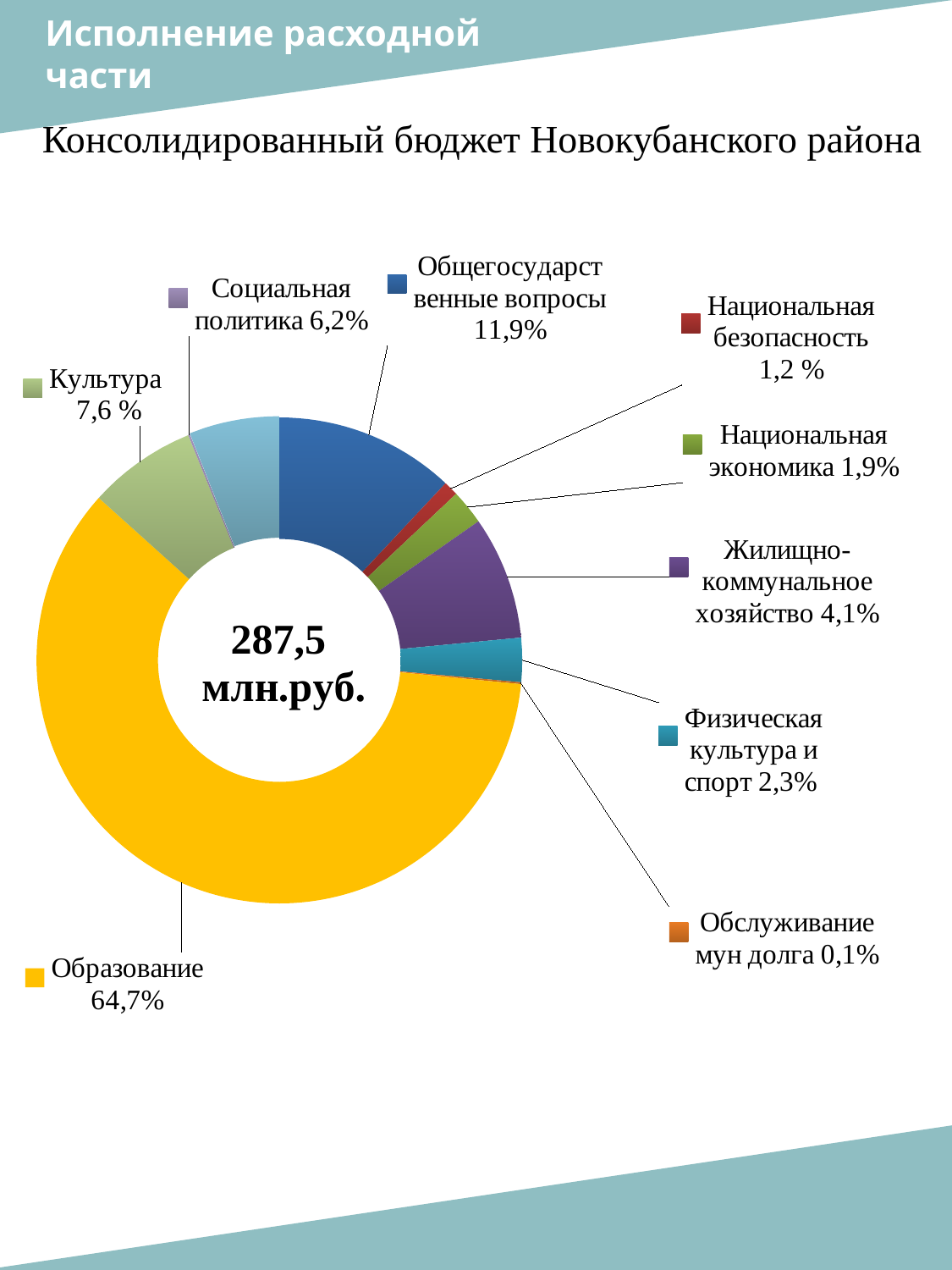
How many categories are shown in the chart? 9 What share of the budget goes to Жилищно-коммунальное хозяйство? 4,1% What share of the budget goes to Культура? 7,6 % Which category has the largest share of the budget? Образование What kind of chart is shown on the slide? Pie (doughnut) chart What share of the budget goes to Общегосударственные вопросы? 11,9% What share of the budget goes to Образование? 64,7% What is the difference in percentage points between Образование and Общегосударственные вопросы? 52,8 What share of the budget goes to Обслуживание мун долга? 0,1% Which category has the smallest share of the budget? Обслуживание мун долга Which has a larger share: Социальная политика or Культура? Культура What total amount is shown in the centre of the chart? 287,5 млн.руб.